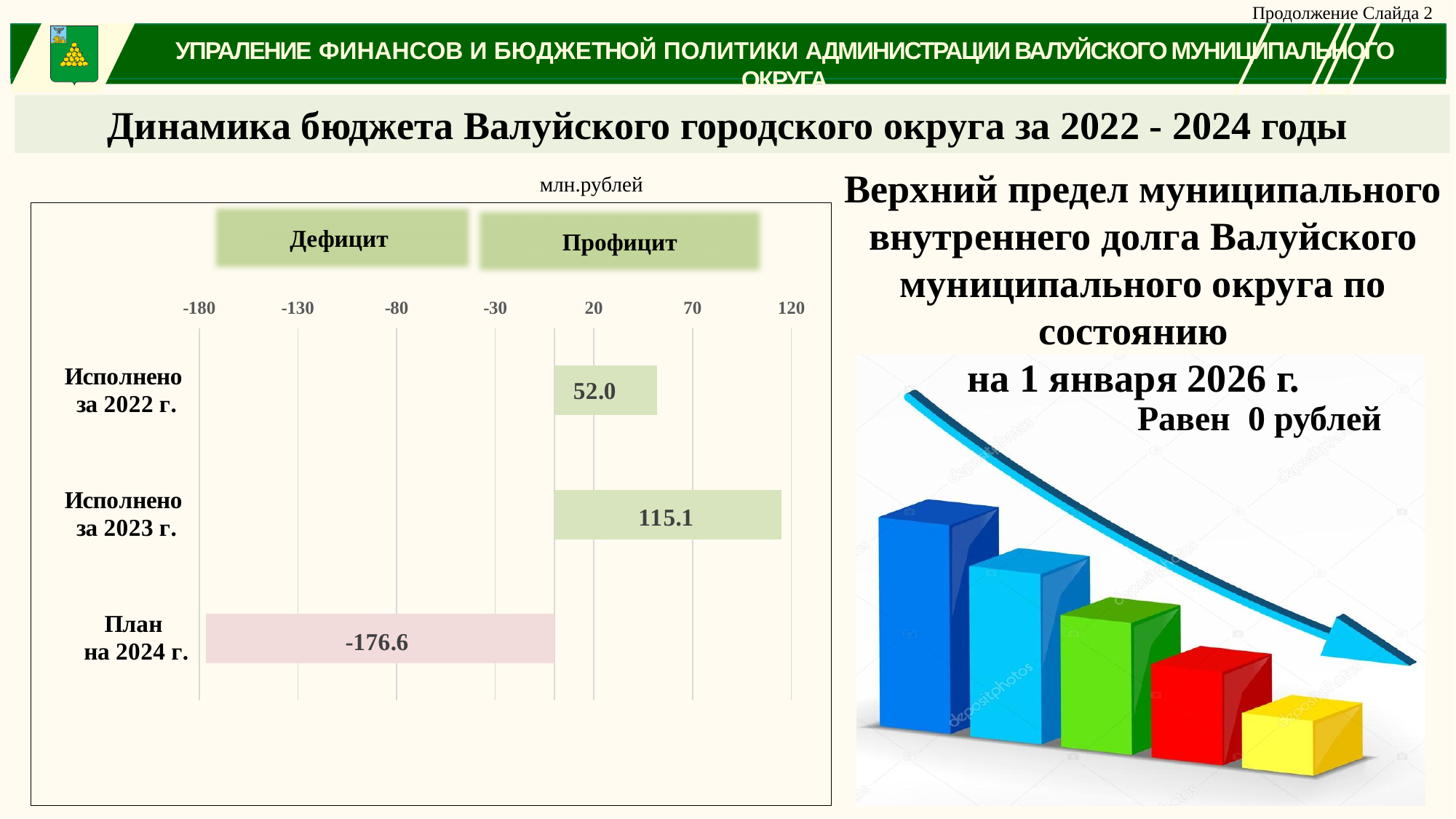
What is the value for "План на 2024 г." on the chart? -176.6 Which category has the lowest value on the chart? План на 2024 г. Which is larger: the value for "Исполнено за 2022 г." or the value for "Исполнено за 2023 г."? Исполнено за 2023 г. What is the difference between the values for "Исполнено за 2023 г." and "Исполнено за 2022 г."? 63.1 What unit of measurement is indicated above the chart? млн.рублей Which category has the highest value on the chart? Исполнено за 2023 г. What type of chart is shown on the slide? bar chart Is the value for "Исполнено за 2023 г." greater or less than 70? greater How many categories are shown on the chart? 3 Which category on the chart falls in the "Дефицит" zone? План на 2024 г. What is the value for "Исполнено за 2022 г." on the chart? 52.0 What is the value for "Исполнено за 2023 г." on the chart? 115.1